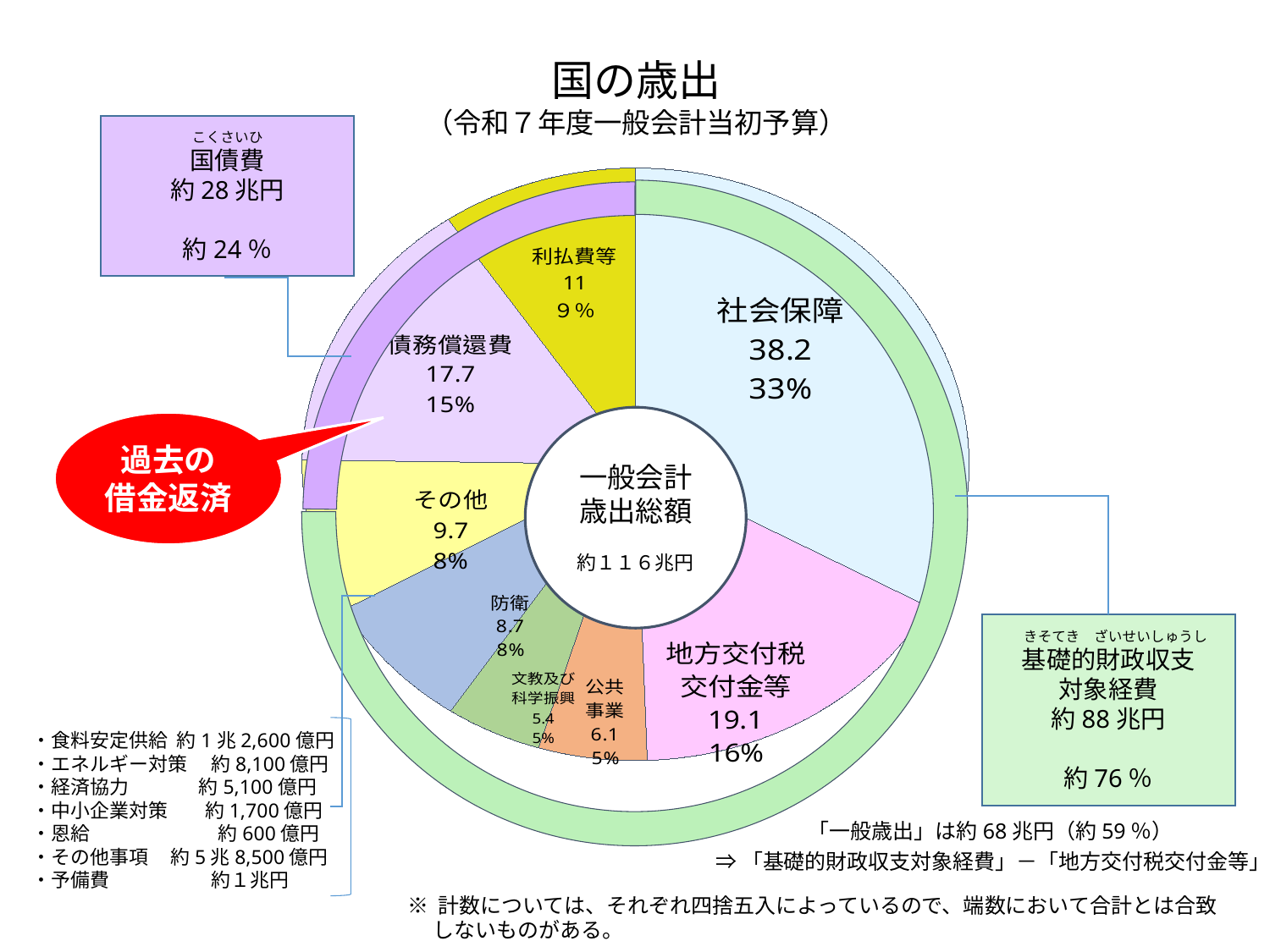
How many slices does the pie chart have? 8 What percentage share does 地方交付税交付金等 have in the pie chart? 16% What total amount is written in the centre of the pie chart? 約１１６兆円 What percentage is shown for 利払費等? 9% What is the value shown for その他? 9.7 What is the difference between the values for 社会保障 and 地方交付税交付金等? 19.1 Which is larger, the value for 防衛 or the value for 公共事業? 防衛 What is the value shown for 社会保障 in the pie chart? 38.2 What is the value shown for 債務償還費? 17.7 Which category has the largest slice in the pie chart? 社会保障 Which category has the smallest slice in the pie chart? 文教及び科学振興 What kind of chart is shown on the slide? pie chart